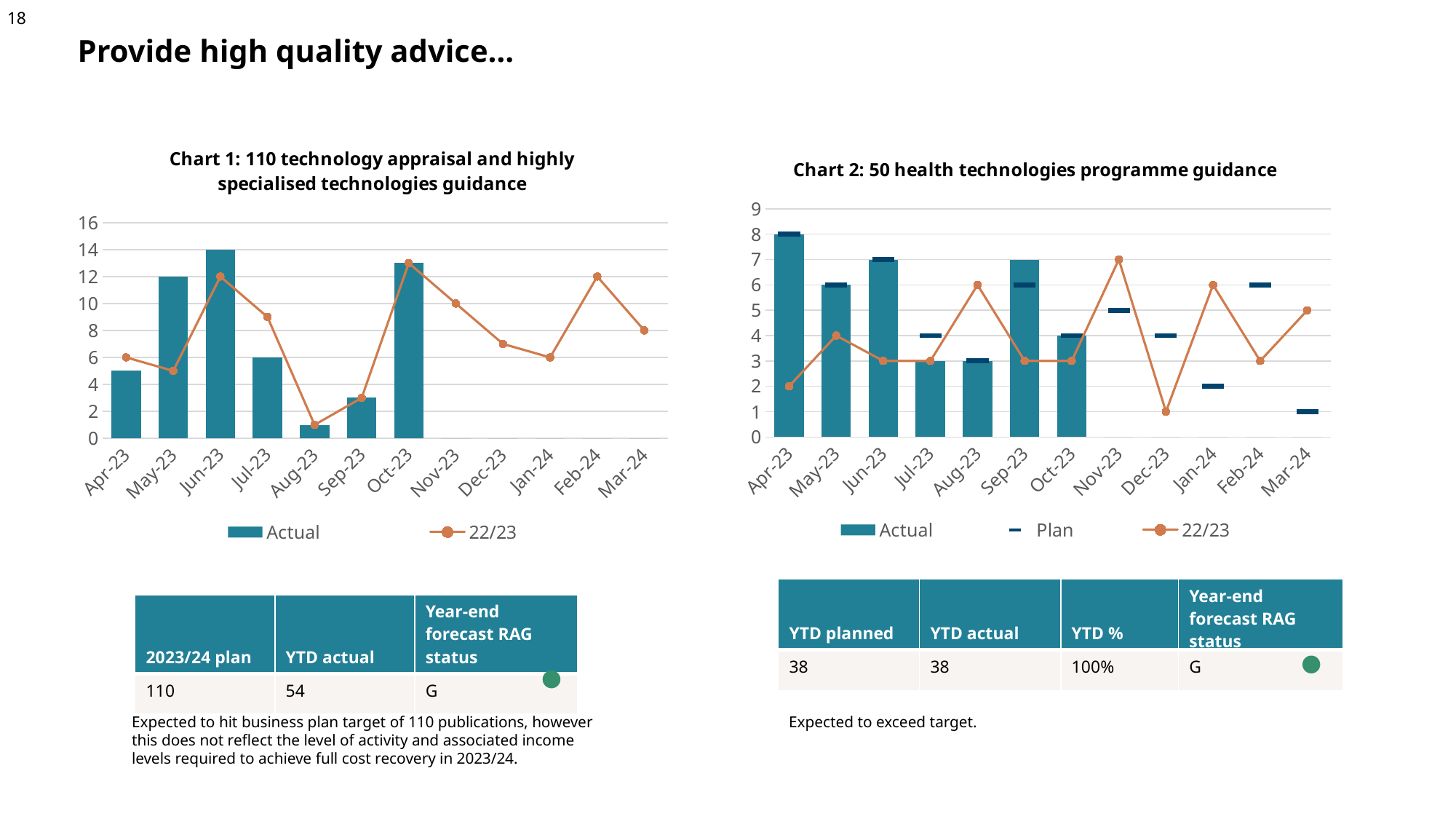
In Chart 2, what is the Plan value for Mar-24? 1 In Chart 1, which month has the lowest Actual value? Aug-23 In Chart 2, how many series does the legend list? 3 How many months are shown on the x axis of Chart 2? 12 In Chart 1, which month has the highest Actual value? Jun-23 In Chart 1, how many series does the legend list? 2 In Chart 2, which month has the highest Actual value? Apr-23 In Chart 1, is the Actual value for May-23 greater or less than 10? greater In Chart 2, is the Actual value for Sep-23 larger than the Actual value for Oct-23? Yes In Chart 1, what is the Actual value for Jun-23? 14 In Chart 2, what is the Actual value for Apr-23? 8